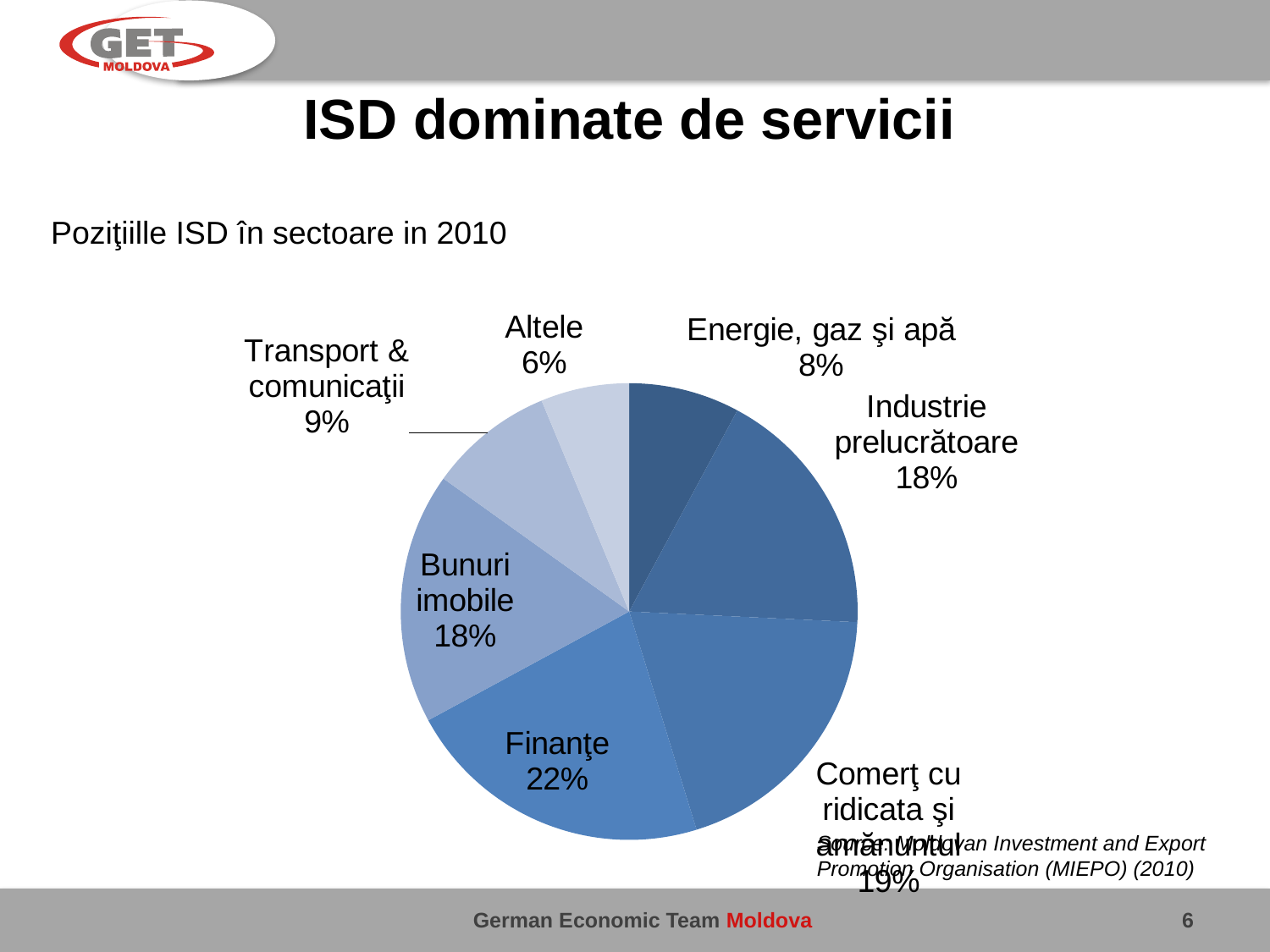
What share is shown for Transport & comunicaţii? 9% What is the combined share of Energie, gaz şi apă and Altele? 14% Which sector has the smallest share in the pie chart? Altele What is the title of the slide containing the pie chart? ISD dominate de servicii What kind of chart is shown on the slide? pie chart What share is shown for Energie, gaz şi apă? 8% What share of ISD does Finanţe hold in the pie chart? 22% Which has a larger share, Industrie prelucrătoare or Transport & comunicaţii? Industrie prelucrătoare What share is shown for Altele? 6% What is the difference between the shares of Finanţe and Bunuri imobile? 4% Which sector has the largest share in the pie chart? Finanţe How many sectors (slices) does the pie chart show? 7